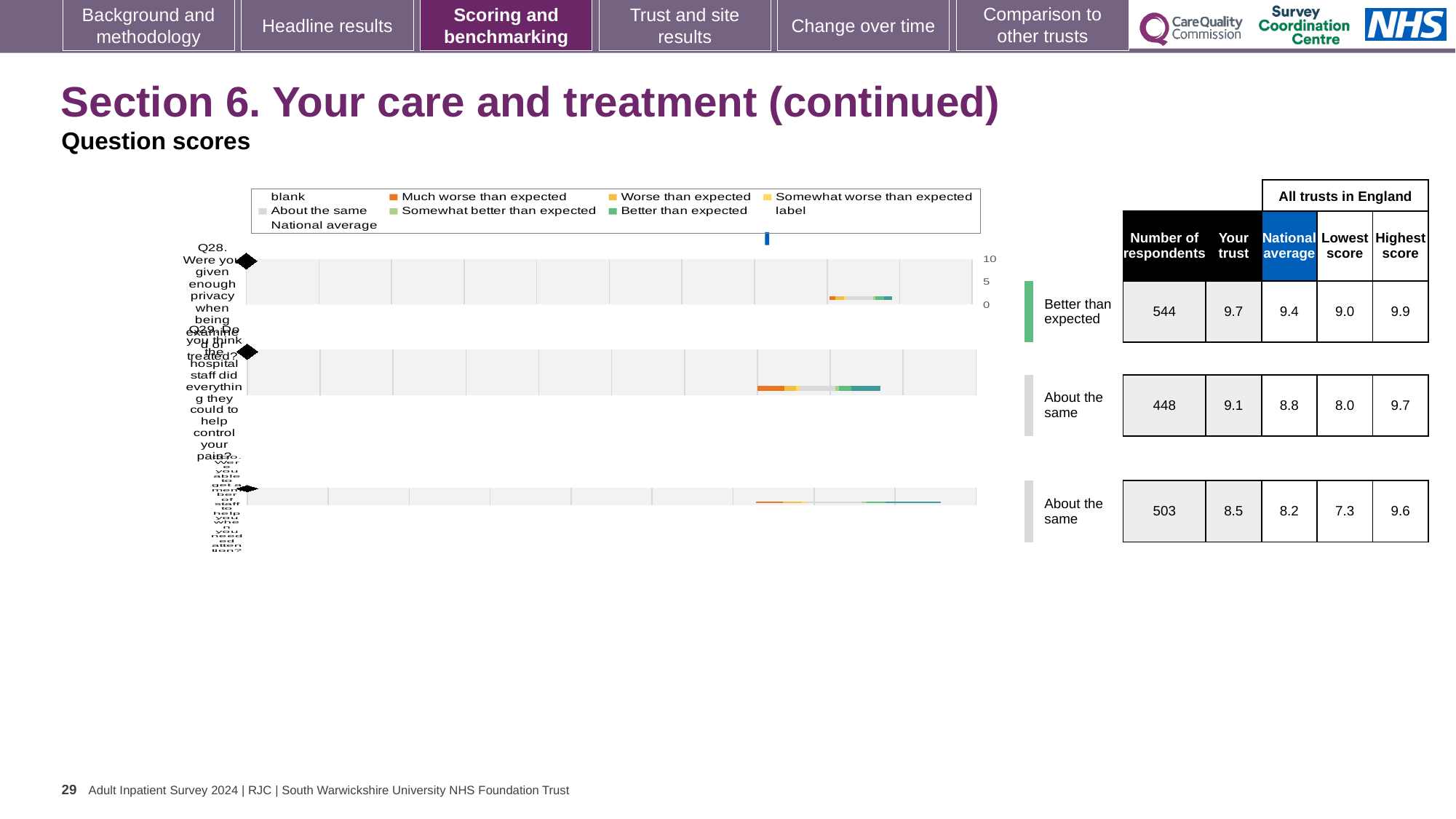
Which question has the highest 'Your trust' score? Q28 How many question rows are plotted in the chart? 3 What is the highest score across all trusts in England for Q29? 9.7 What is the lowest score across all trusts in England for the third question row (Q30)? 7.3 For Q29, which is larger: the 'Your trust' score or the national average? Your trust What is the national average score for Q29 (staff did everything to help control pain)? 8.8 How many respondents are listed for Q28? 544 By how much does the 'Your trust' score for Q28 exceed the national average? 0.3 Which question has the lowest number of respondents? Q29 What is the 'Your trust' score for Q28 (privacy when being examined or treated)? 9.7 What benchmark category is shown for Q28? Better than expected What kind of chart is shown on the slide? bar chart